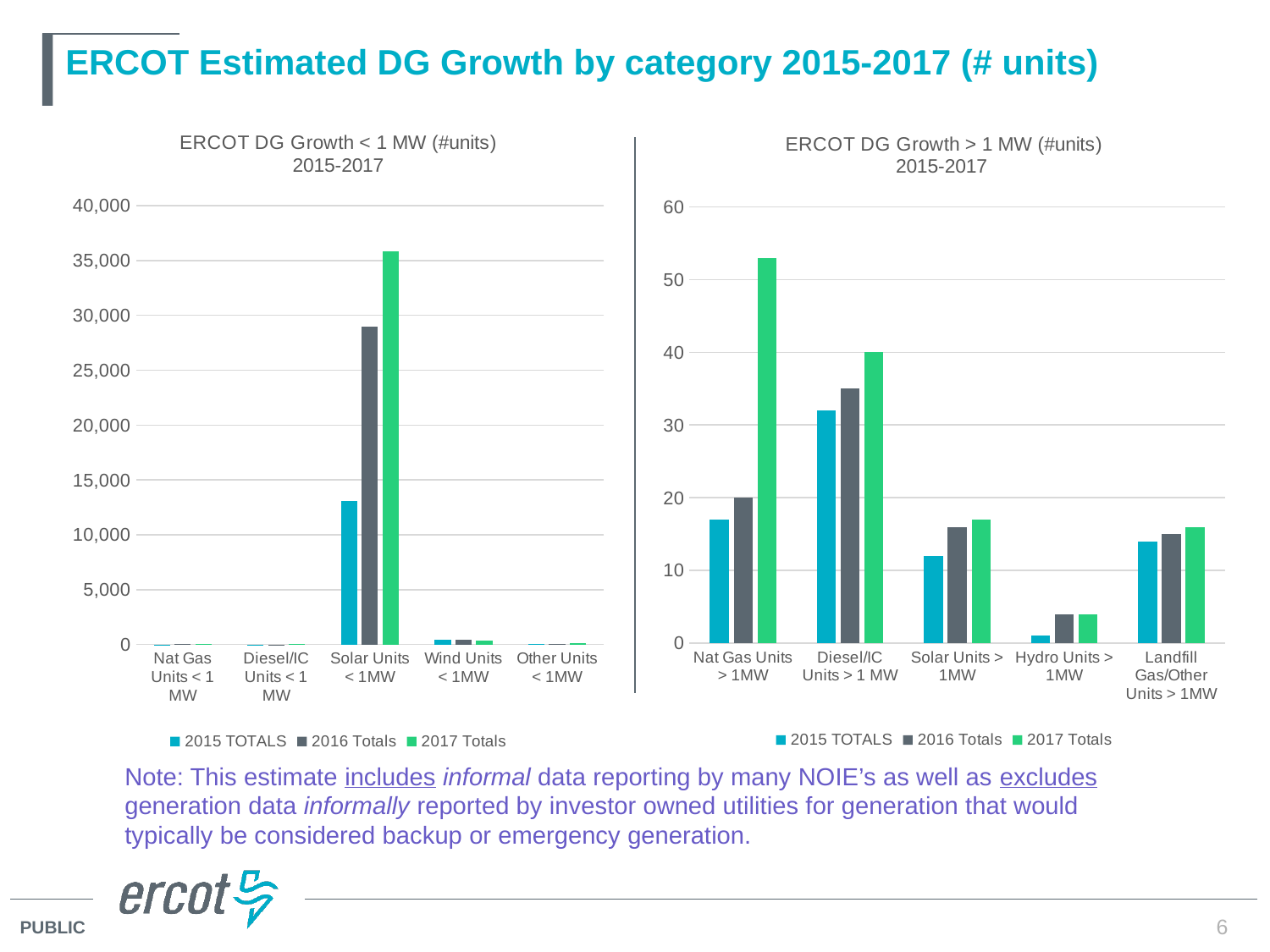
In the 'ERCOT DG Growth > 1 MW (#units) 2015-2017' chart, which category has the highest 2017 Totals value? Nat Gas Units > 1MW In the 'ERCOT DG Growth > 1 MW (#units) 2015-2017' chart, which is larger for 2015 TOTALS: Diesel/IC Units > 1 MW or Nat Gas Units > 1MW? Diesel/IC Units > 1 MW What colour are the 2017 Totals bars in the 'ERCOT DG Growth > 1 MW (#units) 2015-2017' chart? green In the 'ERCOT DG Growth < 1 MW (#units) 2015-2017' chart, is the 2015 TOTALS value for Solar Units < 1MW greater or less than 10,000? greater How many categories are shown on the x axis of the 'ERCOT DG Growth < 1 MW (#units) 2015-2017' chart? 5 In the 'ERCOT DG Growth < 1 MW (#units) 2015-2017' chart, which category has the highest 2017 Totals value? Solar Units < 1MW What kind of chart is the 'ERCOT DG Growth < 1 MW (#units) 2015-2017' chart on the left? bar chart In the 'ERCOT DG Growth > 1 MW (#units) 2015-2017' chart, is the 2017 Totals value for Nat Gas Units > 1MW greater or less than 50? greater In the 'ERCOT DG Growth > 1 MW (#units) 2015-2017' chart, which category has the lowest 2015 TOTALS value? Hydro Units > 1MW In the 'ERCOT DG Growth < 1 MW (#units) 2015-2017' chart, do the values for Solar Units < 1MW rise or fall from 2015 to 2017? rise In the 'ERCOT DG Growth < 1 MW (#units) 2015-2017' chart, is the 2017 Totals value for Solar Units < 1MW greater or less than 30,000? greater How many series does the legend of the 'ERCOT DG Growth > 1 MW (#units) 2015-2017' chart list? 3